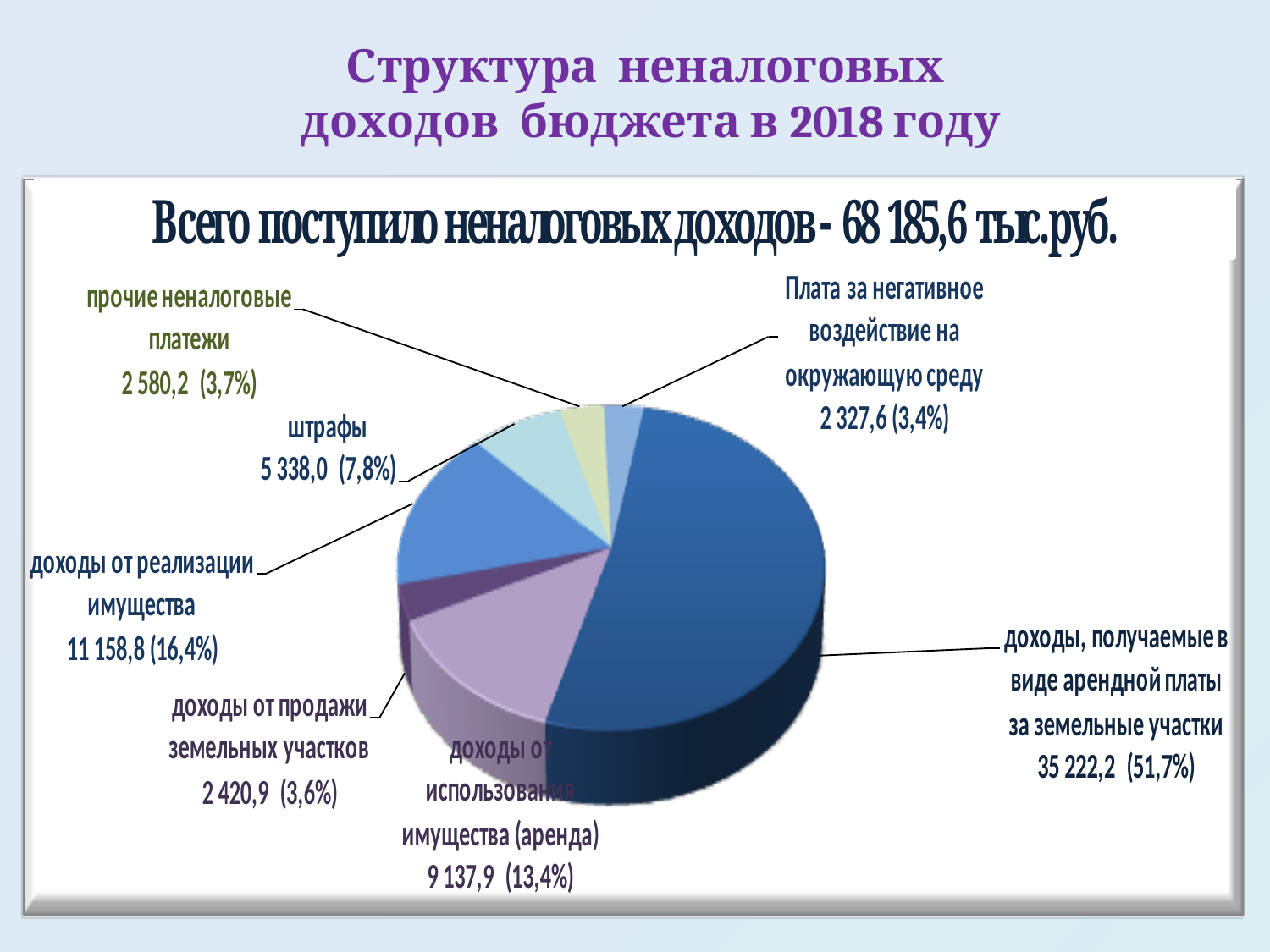
How many slices does the pie chart have? 7 What total amount of non-tax revenue is stated in the chart title? 68 185,6 тыс.руб. What percentage is shown for «доходы от использования имущества (аренда)»? 13,4% Which is larger: «штрафы» or «доходы от продажи земельных участков»? штрафы What is the value shown for «прочие неналоговые платежи»? 2 580,2 What share of the pie does «доходы, получаемые в виде арендной платы за земельные участки» represent? 51,7% What is the value shown for «штрафы»? 5 338,0 What is the difference in percentage points between «доходы от реализации имущества» (16,4%) and «доходы от использования имущества (аренда)» (13,4%)? 3,0% What type of chart is shown on the slide? pie chart Which category has the smallest slice of the pie? Плата за негативное воздействие на окружающую среду What is the value shown for «доходы от реализации имущества»? 11 158,8 Which category has the largest slice of the pie? доходы, получаемые в виде арендной платы за земельные участки